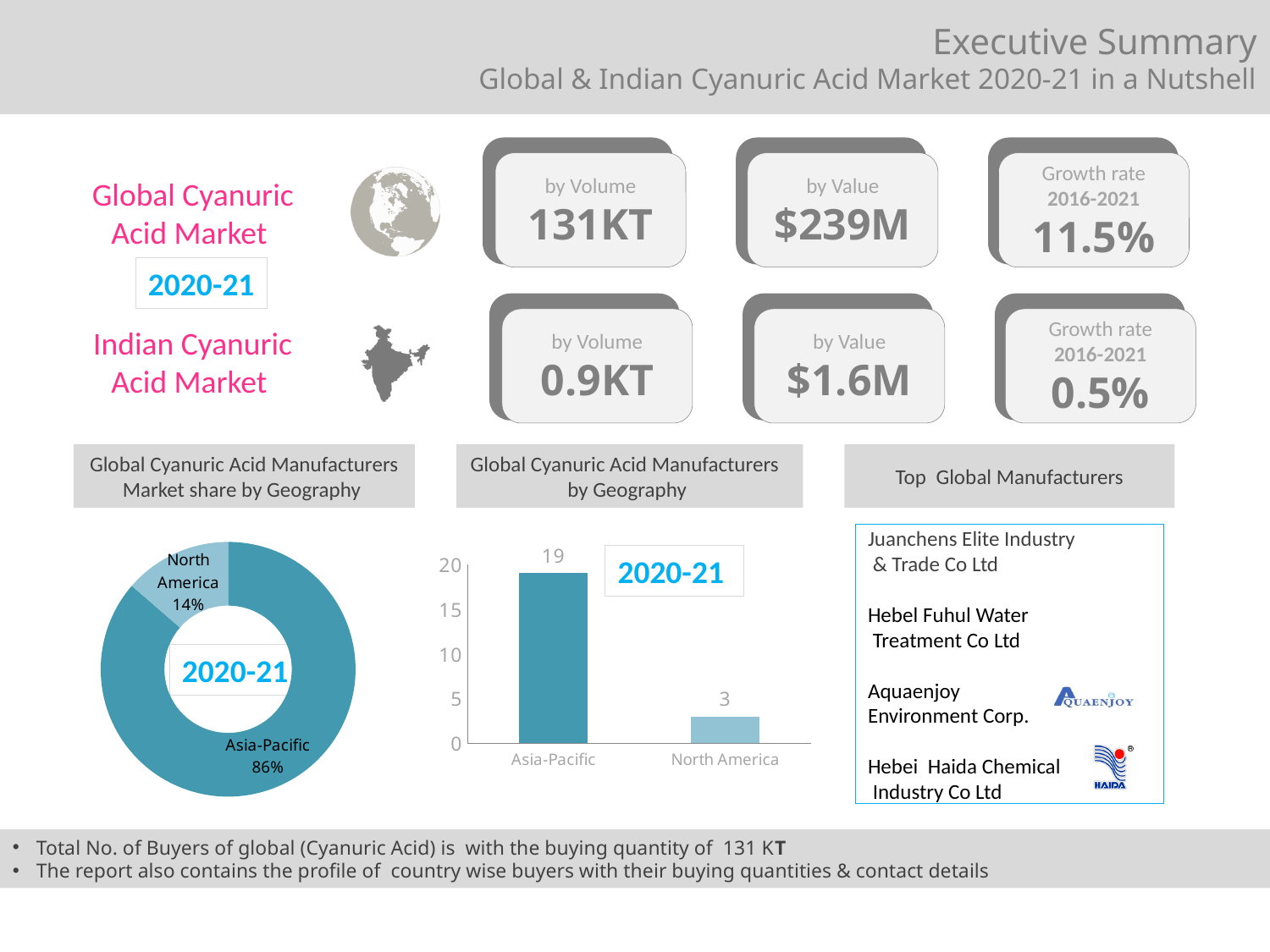
What kind of chart is the 'Global Cyanuric Acid Manufacturers by Geography' chart? Bar chart In the 'Global Cyanuric Acid Manufacturers Market share by Geography' chart, what share does Asia-Pacific hold? 86% In the 'Global Cyanuric Acid Manufacturers Market share by Geography' chart, what share does North America hold? 14% In the 'Global Cyanuric Acid Manufacturers by Geography' chart, what is the difference between Asia-Pacific and North America? 16 In the 'Global Cyanuric Acid Manufacturers Market share by Geography' chart, which region has the largest share? Asia-Pacific In the 'Global Cyanuric Acid Manufacturers by Geography' chart, which region has the lowest value? North America In the 'Global Cyanuric Acid Manufacturers Market share by Geography' chart, how many regions are shown? 2 In the 'Global Cyanuric Acid Manufacturers by Geography' chart, what is the value for Asia-Pacific? 19 What kind of chart is the 'Global Cyanuric Acid Manufacturers Market share by Geography' chart? Doughnut (pie) chart In the 'Global Cyanuric Acid Manufacturers by Geography' chart, what is the value for North America? 3 What year label is shown inside the 'Global Cyanuric Acid Manufacturers Market share by Geography' doughnut chart? 2020-21 In the 'Global Cyanuric Acid Manufacturers by Geography' chart, is the value for Asia-Pacific greater or less than 15? greater